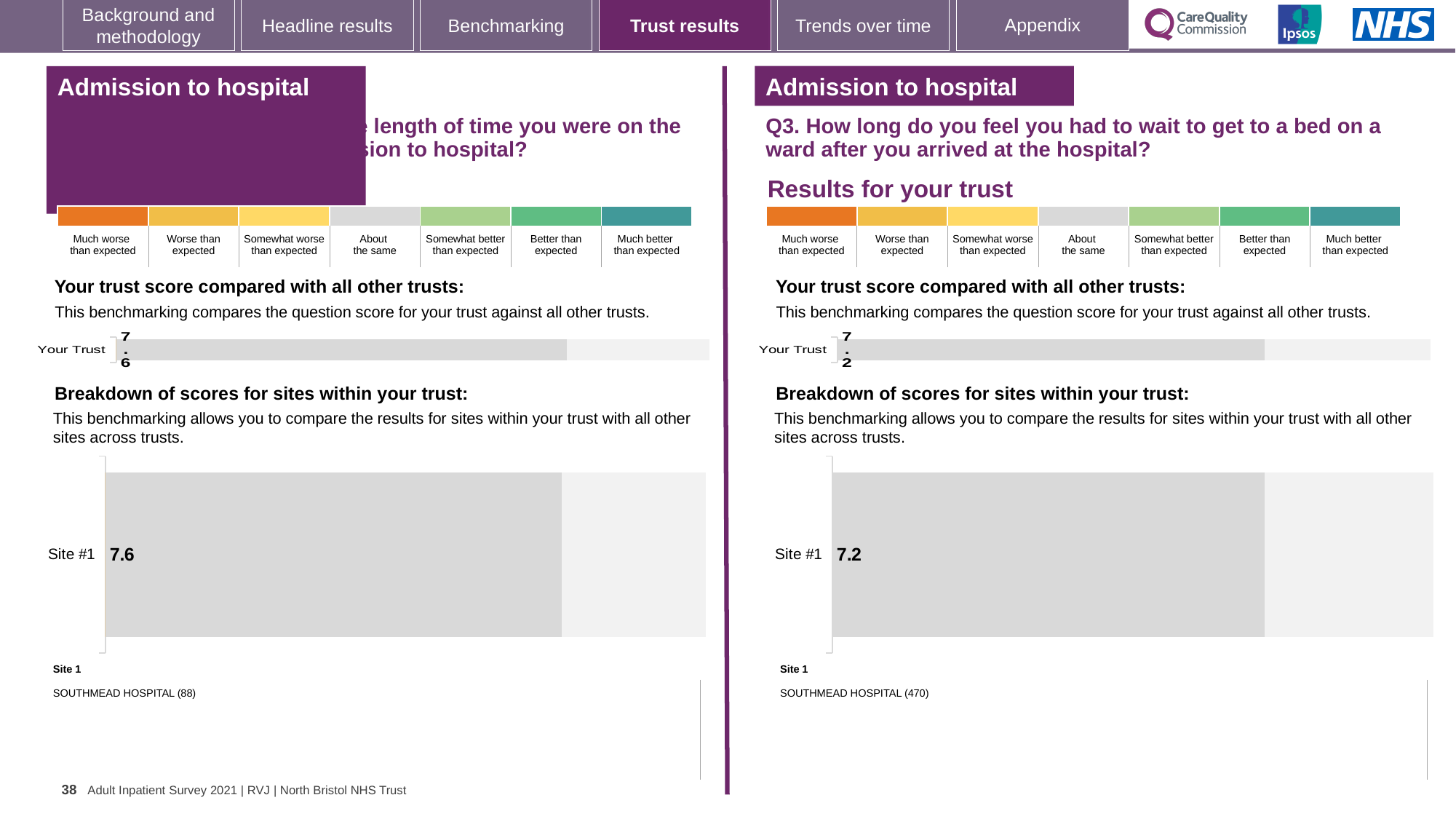
How many sites are shown in the right-hand 'Breakdown of scores for sites within your trust' chart? 1 On the left-hand 'Breakdown of scores for sites within your trust' chart, what is the score for Site #1? 7.6 How many categories does the colour scale above the right-hand chart show, from 'Much worse than expected' to 'Much better than expected'? 7 On the left-hand chart, what is the score shown for Your Trust? 7.6 Which hospital is listed as Site 1 on the right-hand side of the slide? SOUTHMEAD HOSPITAL (470) On the right-hand 'Breakdown of scores for sites within your trust' chart, what is the score for Site #1? 7.2 What is the difference between the Site #1 score on the left-hand chart and the Site #1 score on the right-hand chart? 0.4 What type of chart is used to show the Site #1 score on the right-hand side of the slide? Bar chart Which is larger: the Your Trust score on the left-hand chart or the Your Trust score on the right-hand chart for Q3? Left-hand chart (7.6) On the right-hand chart for Q3 (wait to get to a bed on a ward), what is the score shown for Your Trust? 7.2